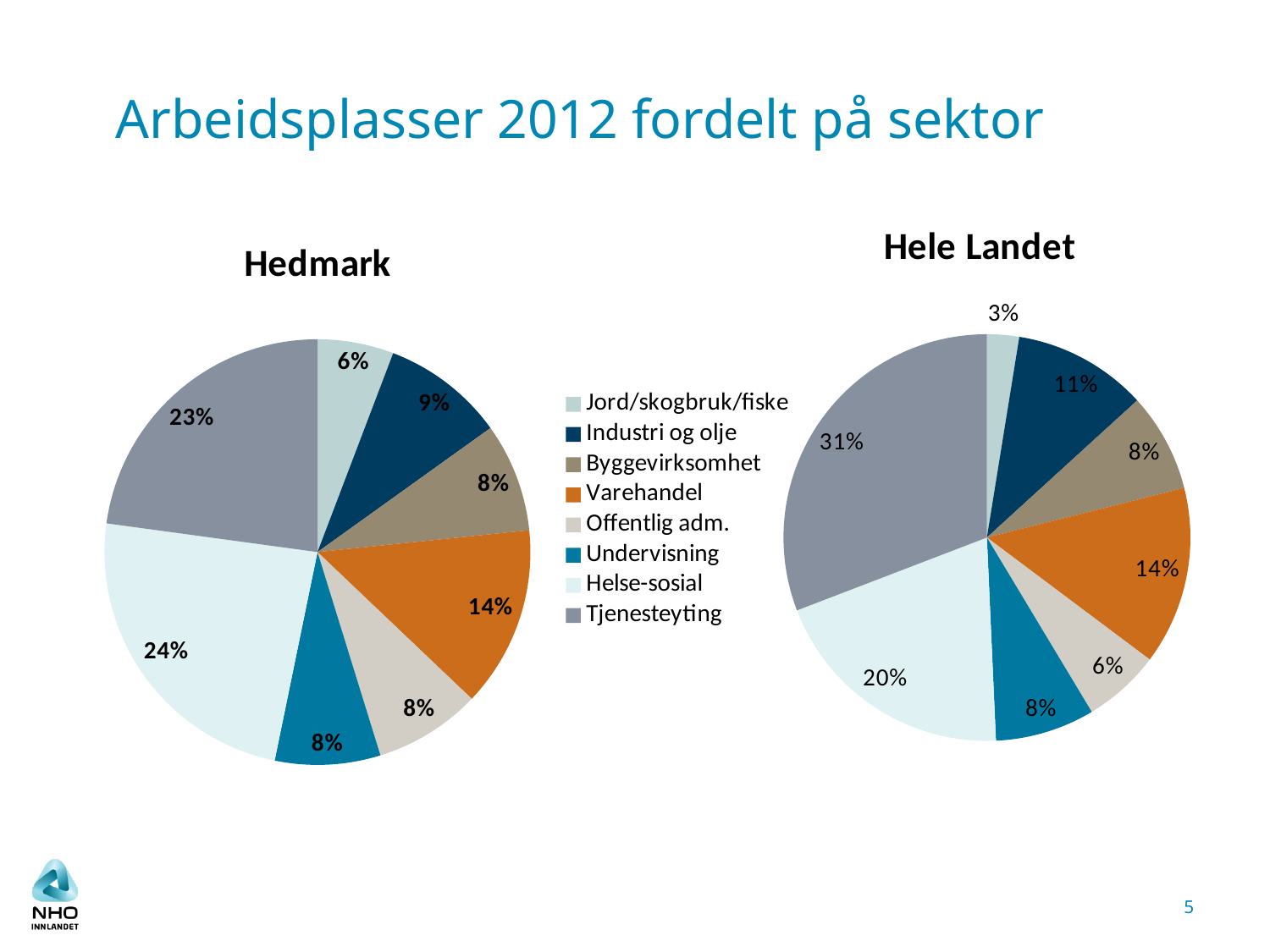
What is the difference between the Tjenesteyting share in the Hele Landet chart and in the Hedmark chart? 8 percentage points How many sectors does the legend list? 8 In the Hedmark chart, what share of jobs is in Varehandel? 14% Is the Industri og olje share larger in the Hedmark chart or in the Hele Landet chart? Hele Landet What type of chart is used for Hedmark and Hele Landet? Pie chart In the Hele Landet chart, which sector has the largest share? Tjenesteyting In the Hedmark chart, what share of jobs is in Helse-sosial? 24% In the Hele Landet chart, what share of jobs is in Tjenesteyting? 31% In the Hele Landet chart, which sector has the smallest share? Jord/skogbruk/fiske In the Hedmark chart, which sector has the smallest share? Jord/skogbruk/fiske In the Hele Landet chart, what share of jobs is in Jord/skogbruk/fiske? 3% In the Hedmark chart, what share of jobs is in Industri og olje? 9%